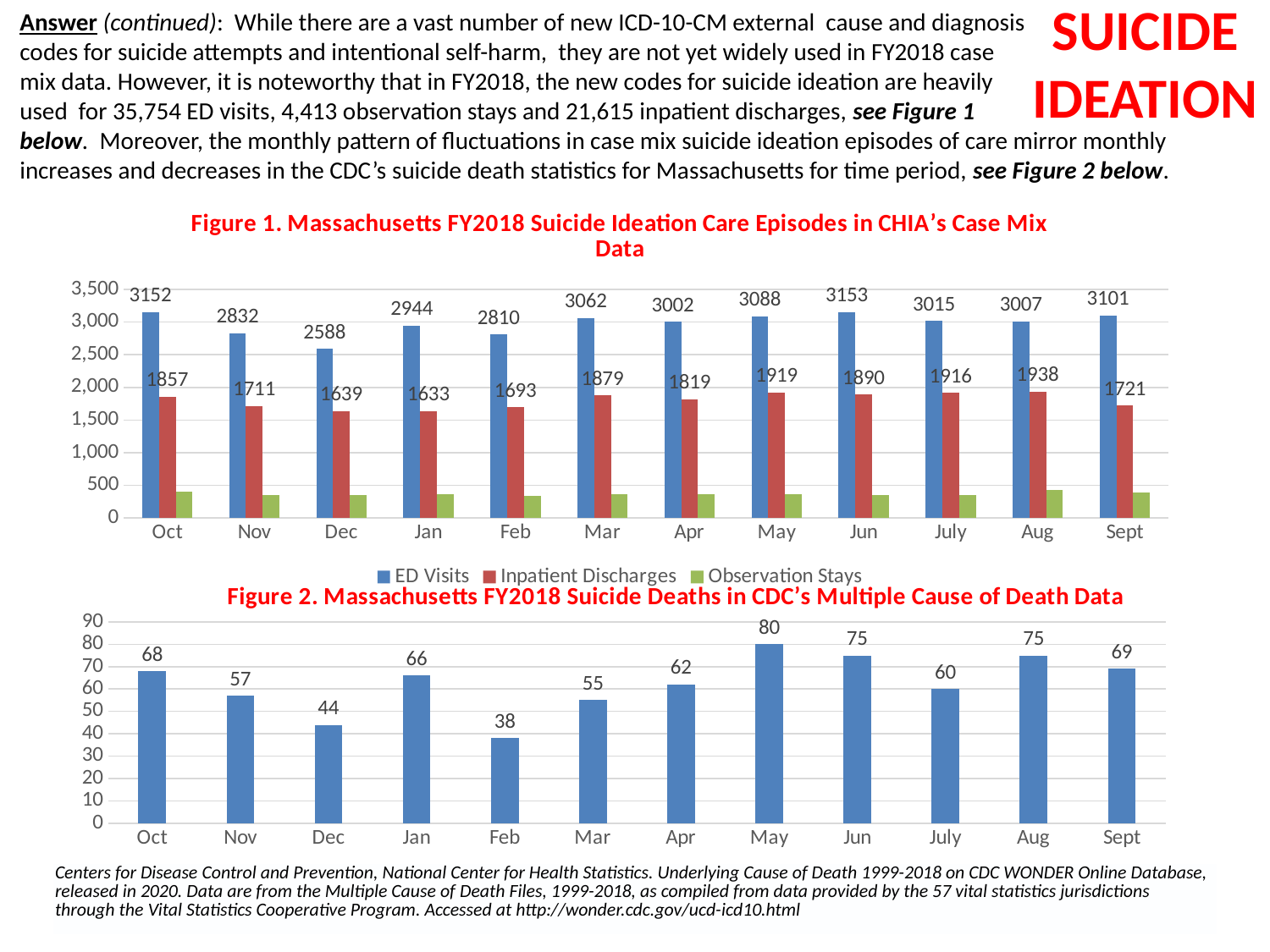
How many months are shown on the x axis of Figure 2? 12 In Figure 1, what is the difference between ED Visits in Oct and ED Visits in Nov? 320 In Figure 1, how many ED Visits were there in Dec? 2588 In Figure 1, is the value for Observation Stays in Oct greater or less than 500? less In Figure 1, what is the value for Inpatient Discharges in May? 1919 In Figure 2, which month has the lowest number of suicide deaths? Feb In Figure 1, which month has the lowest number of ED Visits? Dec How many series does the legend of Figure 1 list? 3 In Figure 2, what is the difference between the values for May and Feb? 42 In Figure 2, what is the value for Apr? 62 In Figure 2, which month has the highest number of suicide deaths? May In Figure 2, which is larger, the value for Jan or the value for Mar? Jan